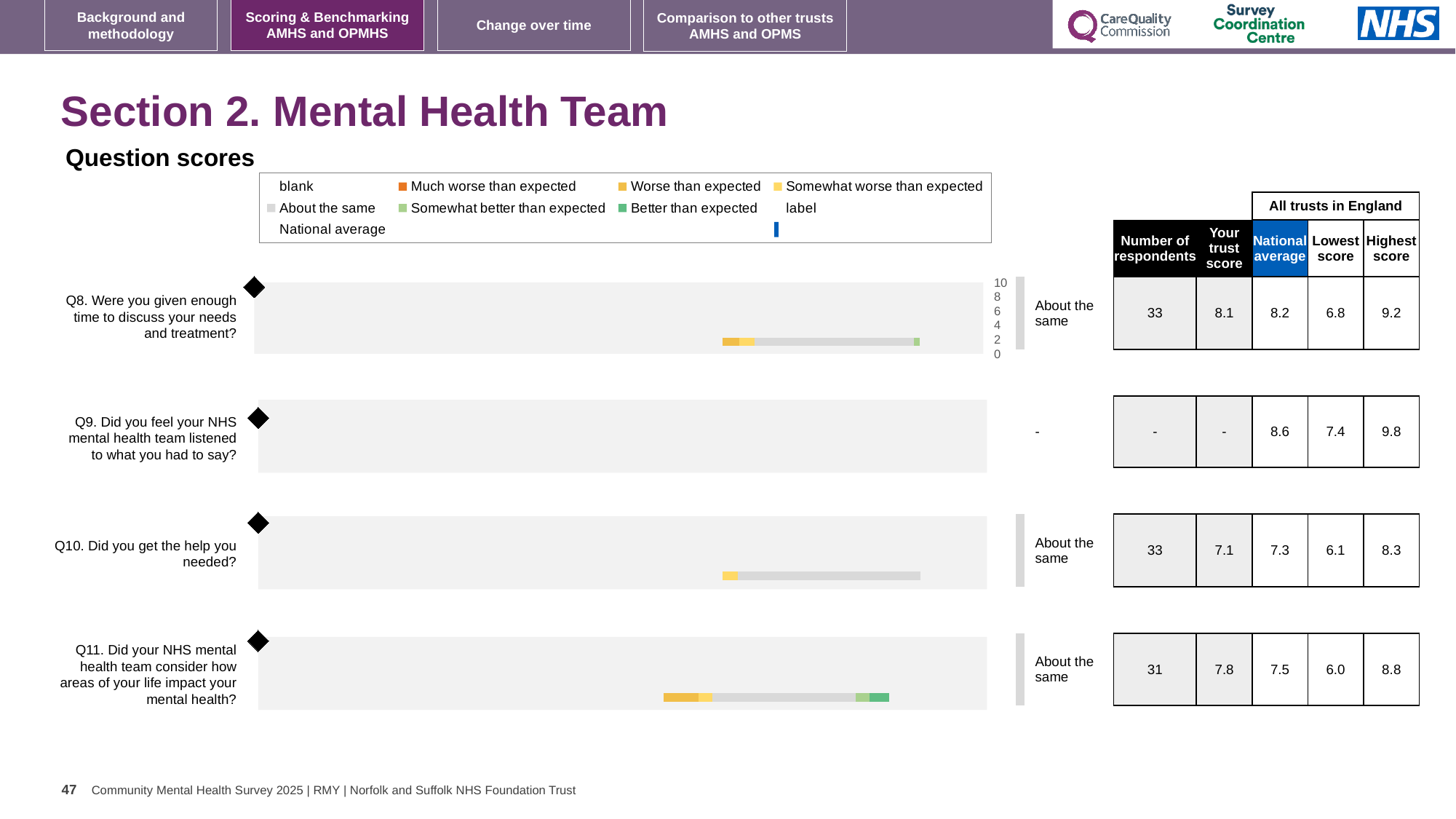
For Q11, how much higher is the trust score than the national average? 0.3 What is the trust score for Q8 (Were you given enough time to discuss your needs and treatment)? 8.1 How many questions (Q8 to Q11) are plotted on the slide? 4 What is the highest score among all trusts in England for Q11? 8.8 For Q10, which is larger: the trust score or the national average? national average How many respondents answered Q10 (Did you get the help you needed)? 33 What benchmark label is shown next to the Q8 chart? About the same Which question has the highest national average? Q9 What kind of chart is used to show the question scores on this slide? bar chart Which question has the lowest 'Lowest score' among all trusts in England? Q11 What is the national average for Q8? 8.2 What is the trust score shown for Q9? -